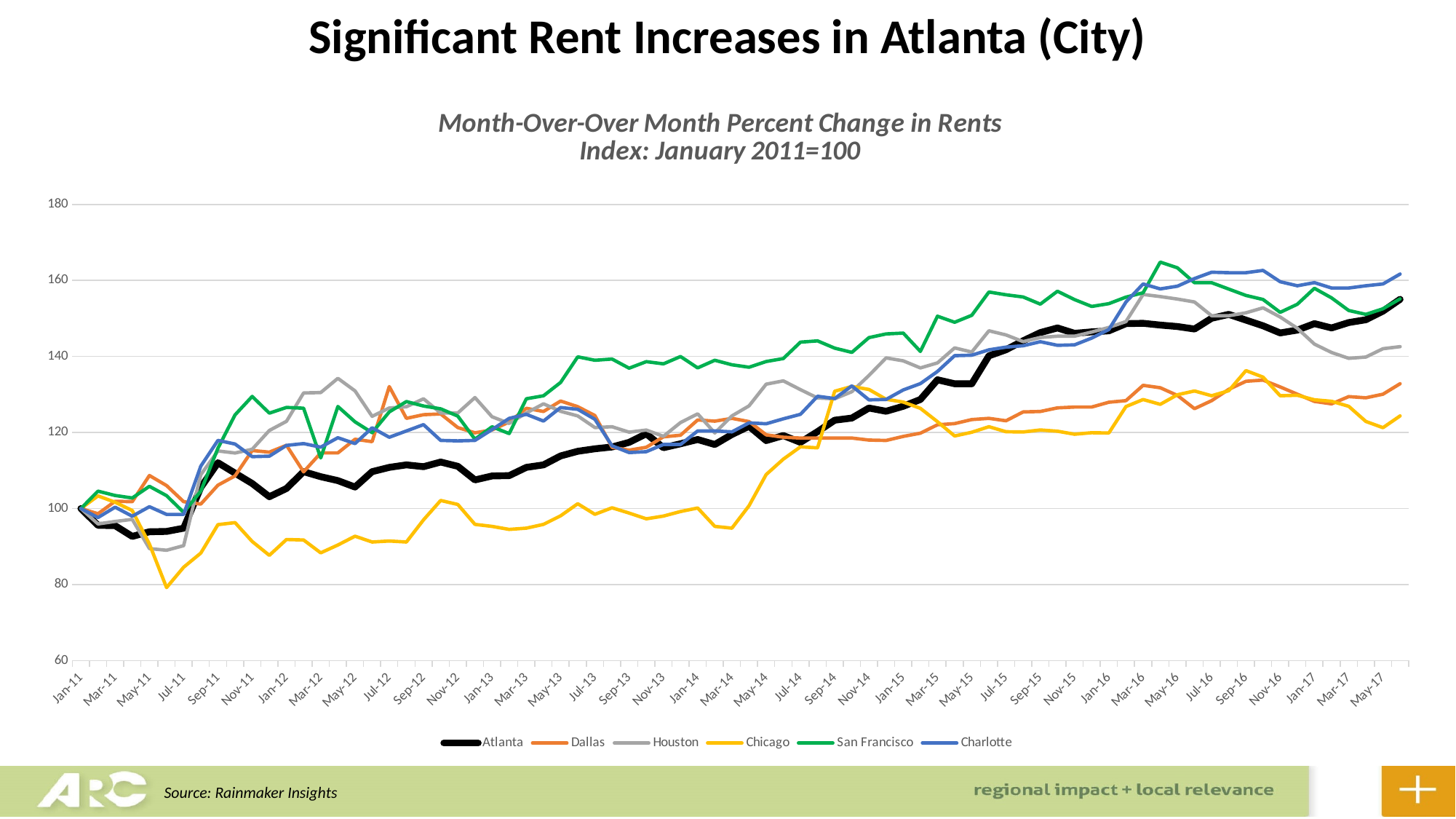
What kind of chart is shown on the slide? line chart Is the value for Atlanta in May-17 greater or less than 140? greater Is the value for Chicago in Mar-12 greater or less than 100? less Which city has the lowest index value in Jan-13? Chicago Is the value for Dallas in May-17 greater or less than 120? greater Which series is drawn with the thick black line? Atlanta What is the index value for Atlanta in Jan-11? 100 In Jan-14, which is larger, the value for Atlanta or the value for Chicago? Atlanta Which city has the highest index value in May-16? San Francisco How many series does the legend list? 6 Does the Atlanta line generally rise or fall from Jan-11 to May-17? rise